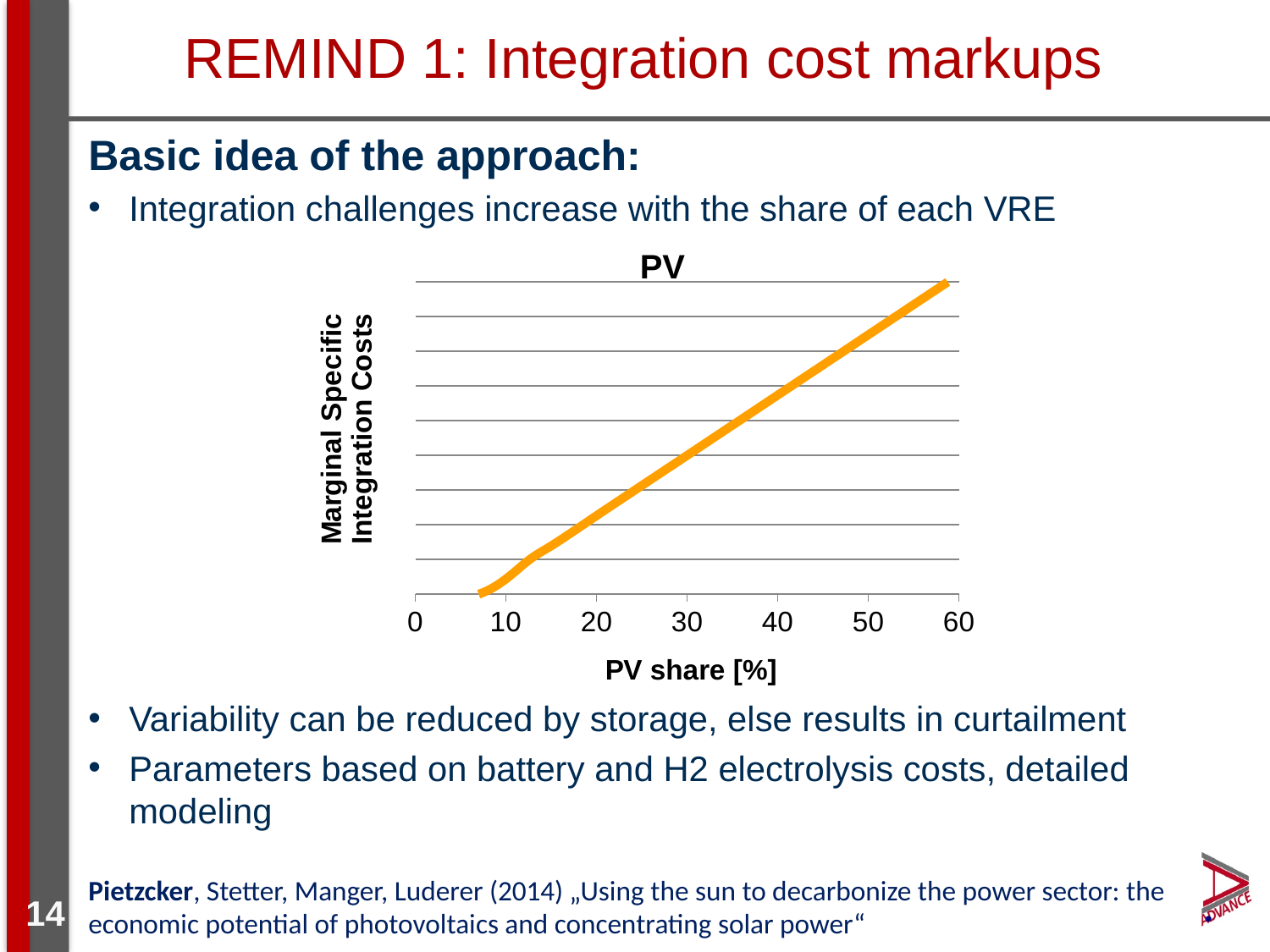
What kind of chart is shown on the slide? line chart What is the highest value shown on the x axis of the chart? 60 How many lines are plotted in the chart? 1 What is the title of the chart? PV What is the lowest value shown on the x axis of the chart? 0 Is the PV share at which the plotted line ends greater or less than 50? greater What is the label of the x axis of the chart? PV share [%] Do the marginal specific integration costs rise or fall as the PV share increases? rise Is the PV share at which the plotted line begins greater or less than 10? less